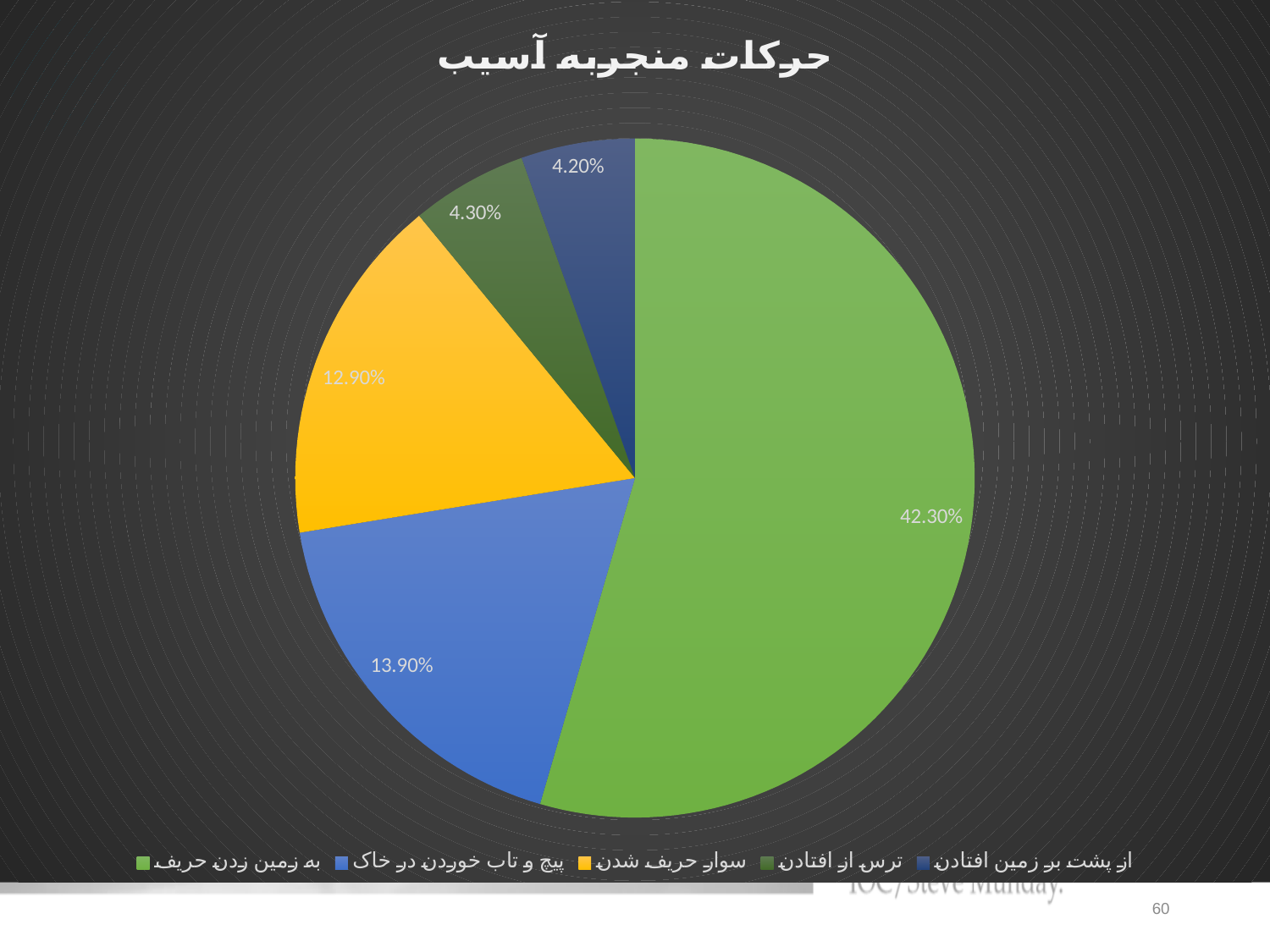
Which colour represents سوار حریف شدن in the legend? yellow How many slices does the pie chart have? 5 What percentage is shown for سوار حریف شدن? 12.90% What percentage is shown for به زمین زدن حریف? 42.30% What is the difference between the percentages for پیچ و تاب خوردن در خاک and سوار حریف شدن? 1.00% What percentage is shown for از پشت بر زمین افتادن? 4.20% What percentage is shown for پیچ و تاب خوردن در خاک? 13.90% Which category has the largest slice of the pie? به زمین زدن حریف Which category has the smallest slice of the pie? از پشت بر زمین افتادن What type of chart is shown on the slide? pie chart What is the title of the chart? حرکات منجربه آسیب What percentage is shown for ترس از افتادن? 4.30%